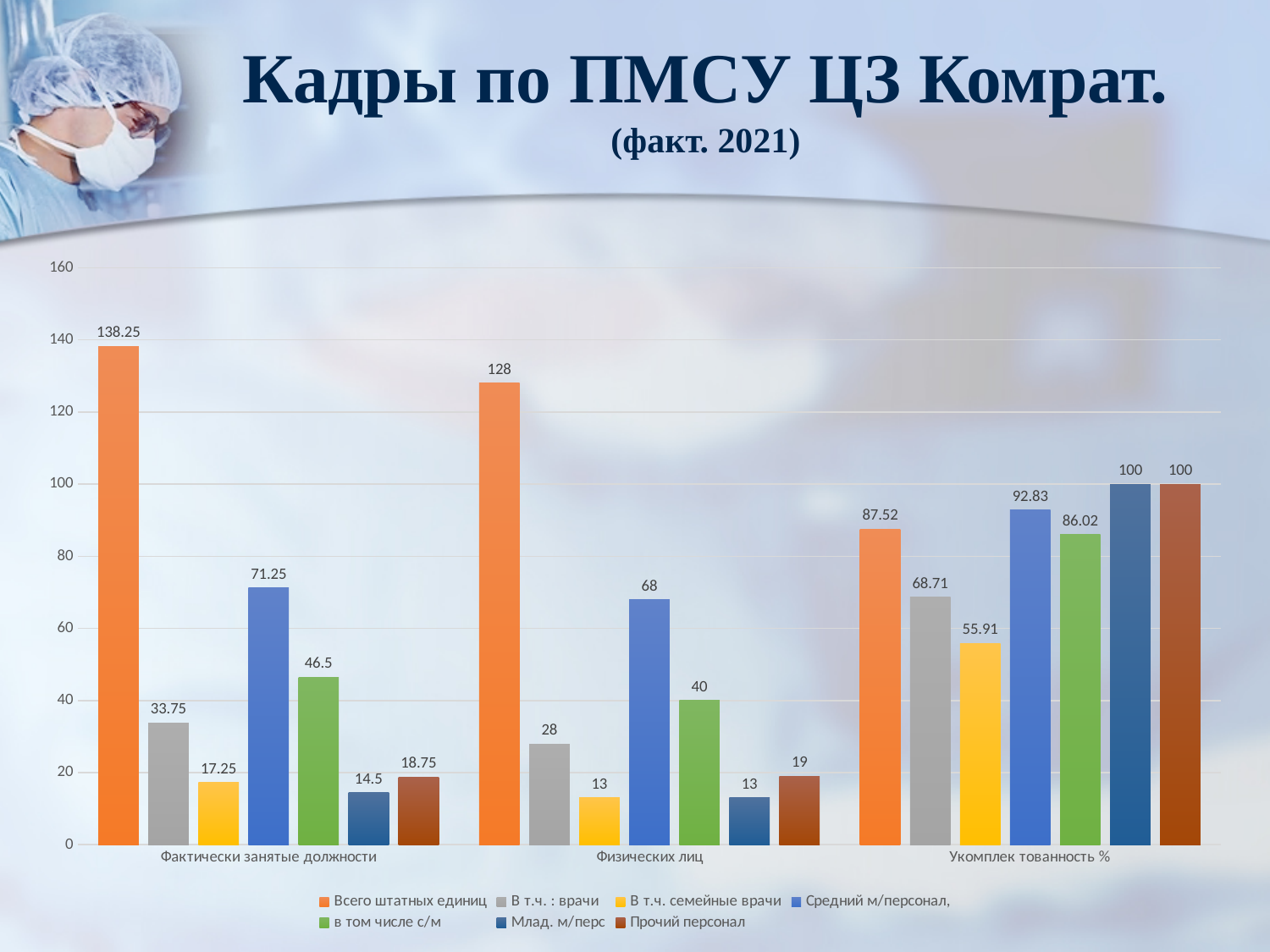
Which is larger in the 'Укомплек тованность %' group: 'Средний м/персонал,' or 'в том числе с/м'? Средний м/персонал, Which series has the lowest value in the 'Фактически занятые должности' group? Млад. м/перс What is the value of 'В т.ч. семейные врачи' for 'Укомплек тованность %'? 55.91 What is the difference between 'Всего штатных единиц' for 'Фактически занятые должности' and for 'Физических лиц'? 10.25 What is the value of 'Средний м/персонал,' for 'Физических лиц'? 68 How many categories are shown on the x axis? 3 What kind of chart is shown on the slide? Bar chart What is the value of 'Всего штатных единиц' for 'Фактически занятые должности'? 138.25 Which series has the highest value in the 'Физических лиц' group? Всего штатных единиц What is the value of 'Прочий персонал' for 'Фактически занятые должности'? 18.75 Is the value of 'В т.ч. : врачи' for 'Укомплек тованность %' greater or less than 60? greater How many series does the legend list? 7